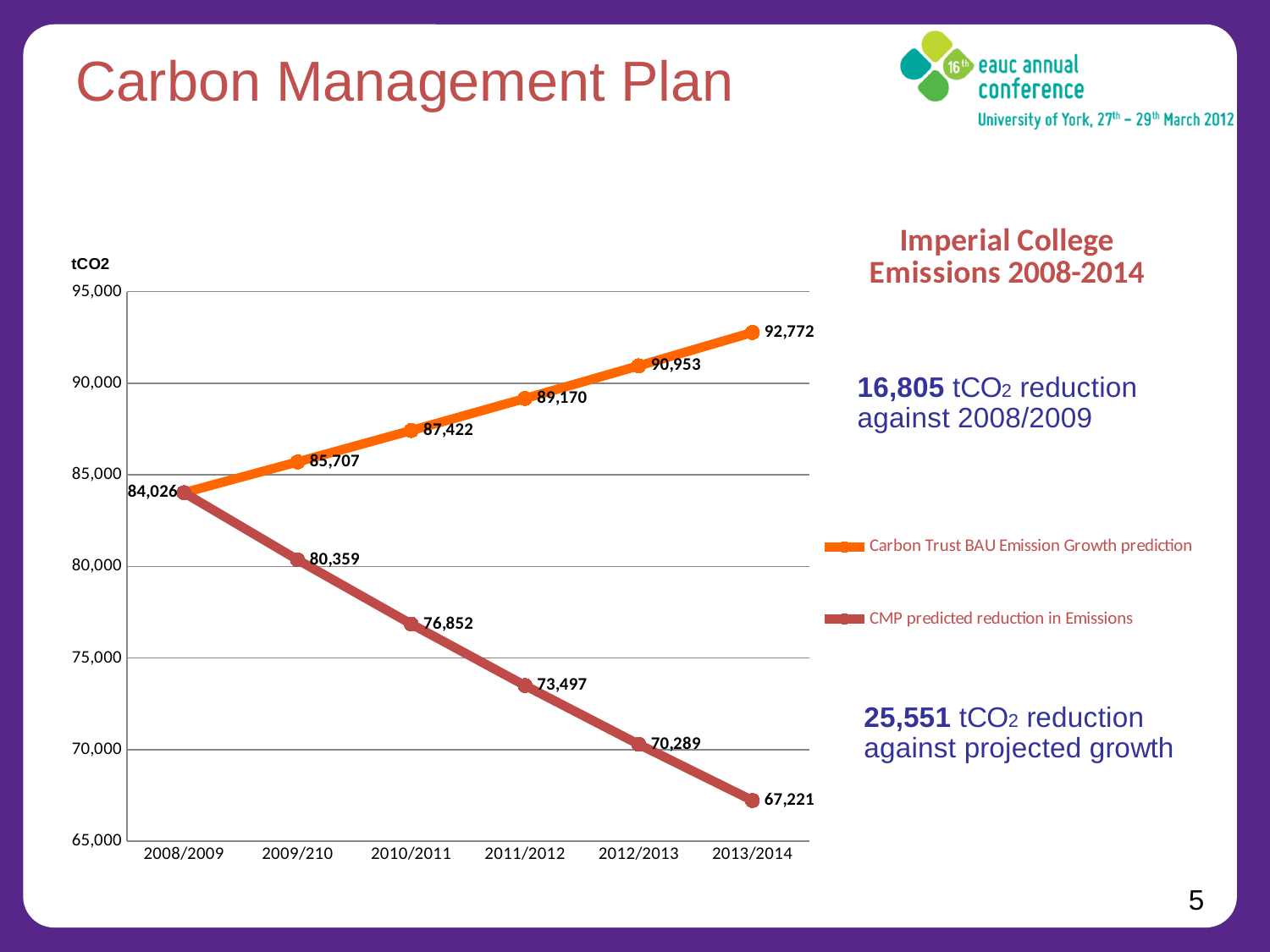
Which series has the larger value in 2010/2011, Carbon Trust BAU Emission Growth prediction or CMP predicted reduction in Emissions? Carbon Trust BAU Emission Growth prediction In which year is the Carbon Trust BAU Emission Growth prediction series highest? 2013/2014 Does the CMP predicted reduction in Emissions series rise or fall from 2008/2009 to 2013/2014? Fall In which year is the CMP predicted reduction in Emissions series lowest? 2013/2014 How many series does the legend list? 2 What type of chart is shown on the slide? Line chart What is the difference between the Carbon Trust BAU prediction and the CMP predicted reduction in 2013/2014? 25,551 What is the Carbon Trust BAU Emission Growth prediction value for 2013/2014? 92,772 What is the difference between the CMP predicted reduction values for 2008/2009 and 2013/2014? 16,805 What value do both series share in 2008/2009? 84,026 What is the CMP predicted reduction in Emissions value for 2011/2012? 73,497 How many years are shown on the x axis? 6